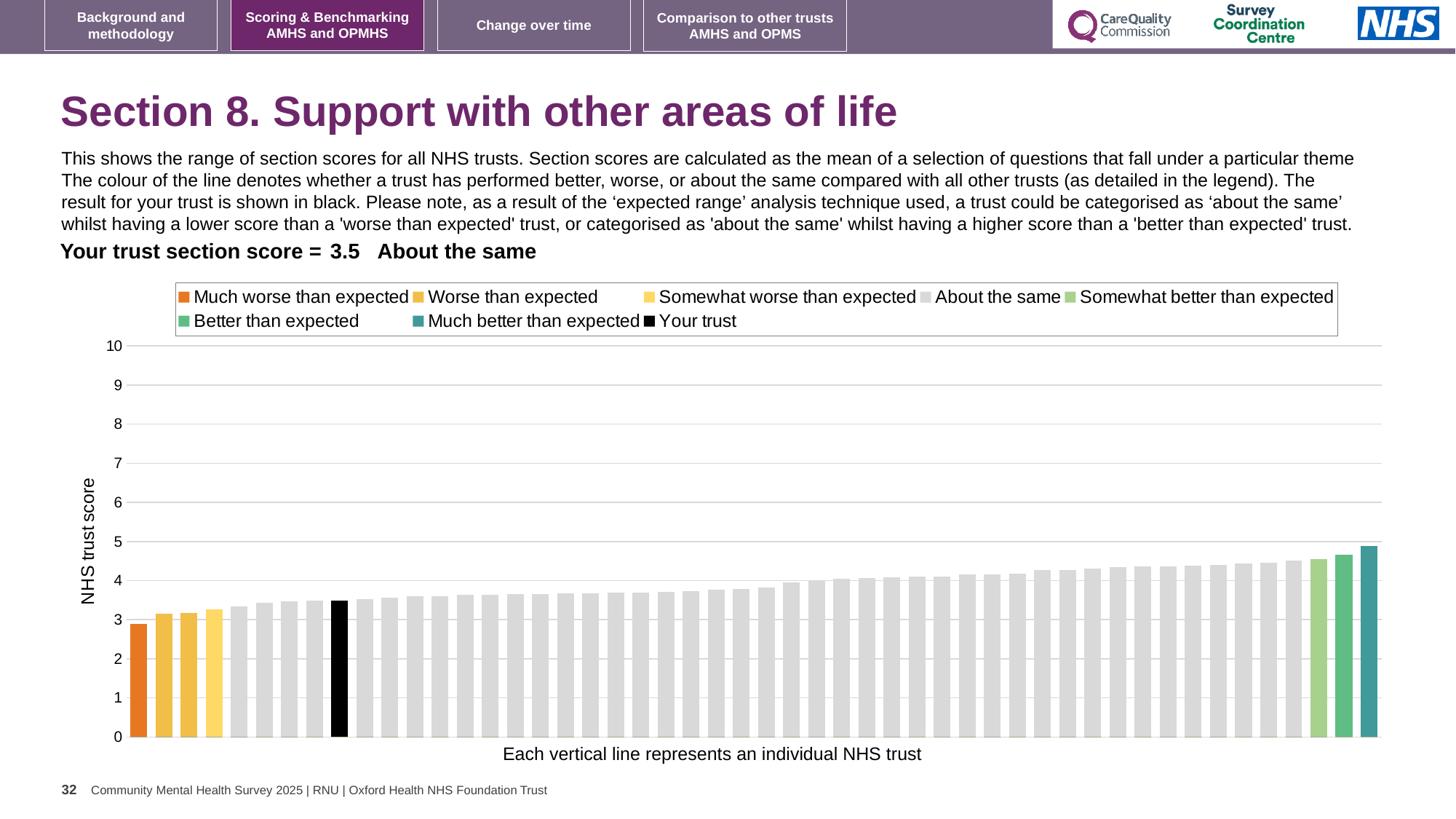
Is the value of the tallest bar greater or less than 4? greater What kind of chart is shown on the slide? bar chart Is the value of the shortest bar greater or less than 2? greater Which legend category does the tallest bar belong to? Much better than expected Do the bar values rise or fall from left to right along the x axis? rise Is the value of the black 'Your trust' bar greater or less than 4? less Is the 'Your trust' bar higher or lower than the orange 'Much worse than expected' bar? higher What is the section score for your trust? 3.5 Which category is your trust placed in for this section? About the same Which legend category does the shortest bar belong to? Much worse than expected What is the label on the vertical axis of the chart? NHS trust score How many entries does the chart legend list? 8